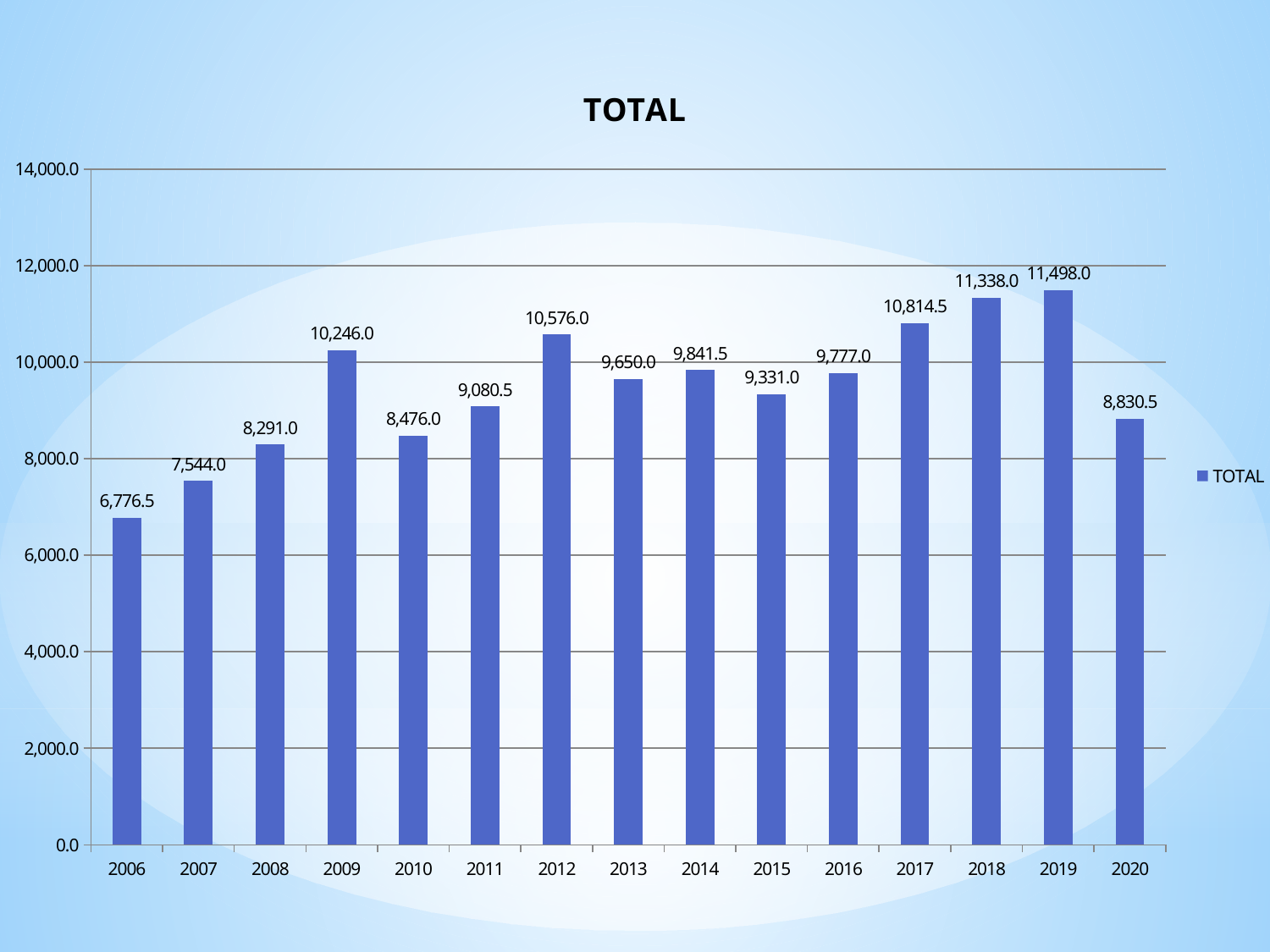
What is the difference between the values for 2012 and 2010? 2,100.0 Which year has the highest value? 2019 Which is larger, the value for 2014 or the value for 2016? 2014 What is the difference between the values for 2019 and 2018? 160.0 What is the value for 2009? 10,246.0 What is the title of the chart? TOTAL How many years are shown on the x axis? 15 What kind of chart is shown? bar chart What is the value for 2015? 9,331.0 Is the value for 2017 greater or less than 10,000.0? greater What is the value for 2020? 8,830.5 Which year has the lowest value? 2006